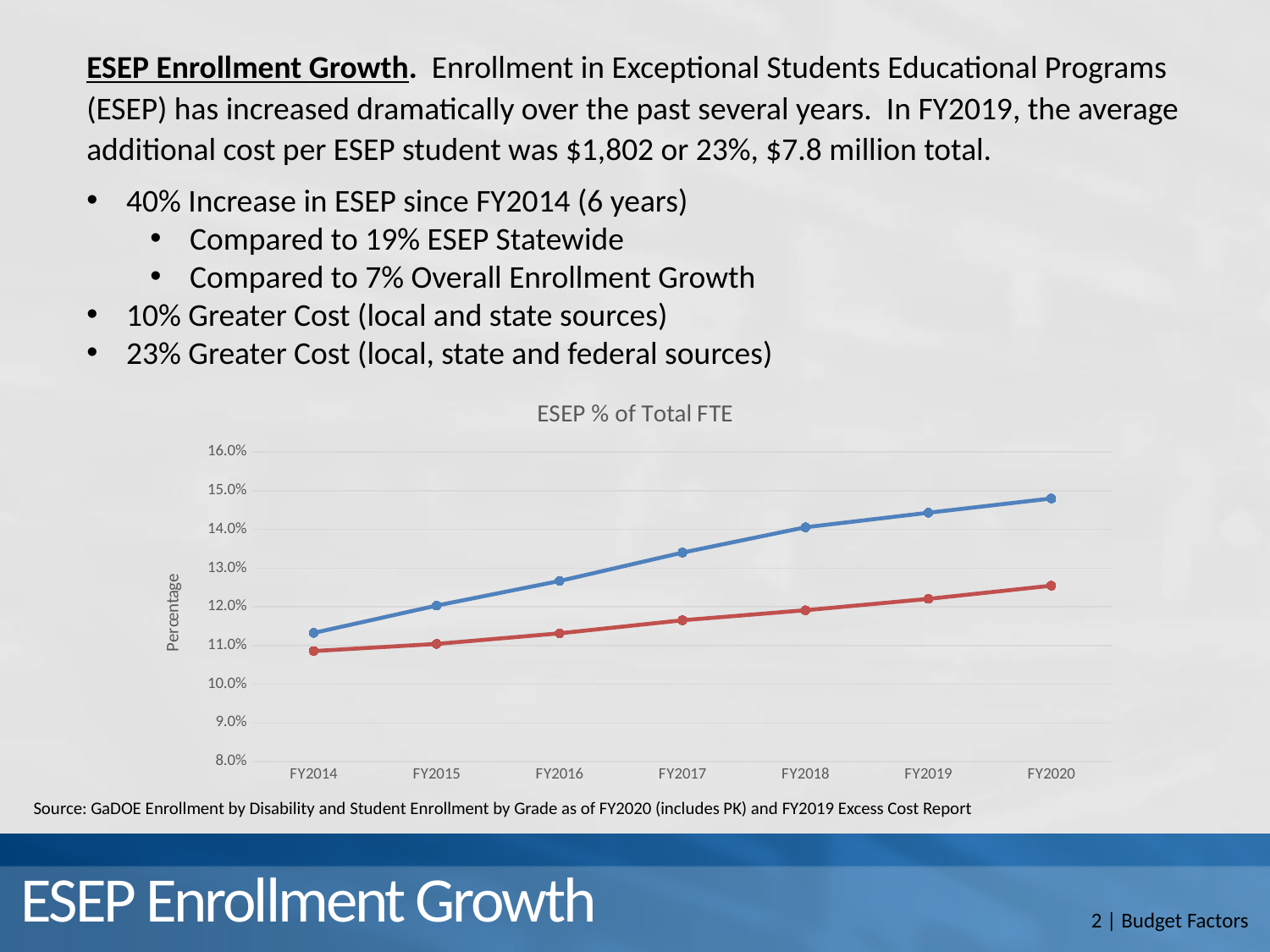
Is the value of the blue line for FY2017 greater or less than 13.0%? greater Is the value of the red line for FY2020 greater or less than 12.0%? greater Does the blue line rise or fall from FY2014 to FY2020? Rise Is the value of the blue line for FY2014 greater or less than 11.0%? greater What is the title of the chart? ESEP % of Total FTE What is the label on the vertical axis of the chart? Percentage In which fiscal year does the blue line reach its highest value? FY2020 How many fiscal years are plotted along the x axis of the chart? 7 Does the red line rise or fall from FY2014 to FY2020? Rise In FY2020, which line has the higher value, the blue line or the red line? Blue line What type of chart is shown on the slide? Line chart